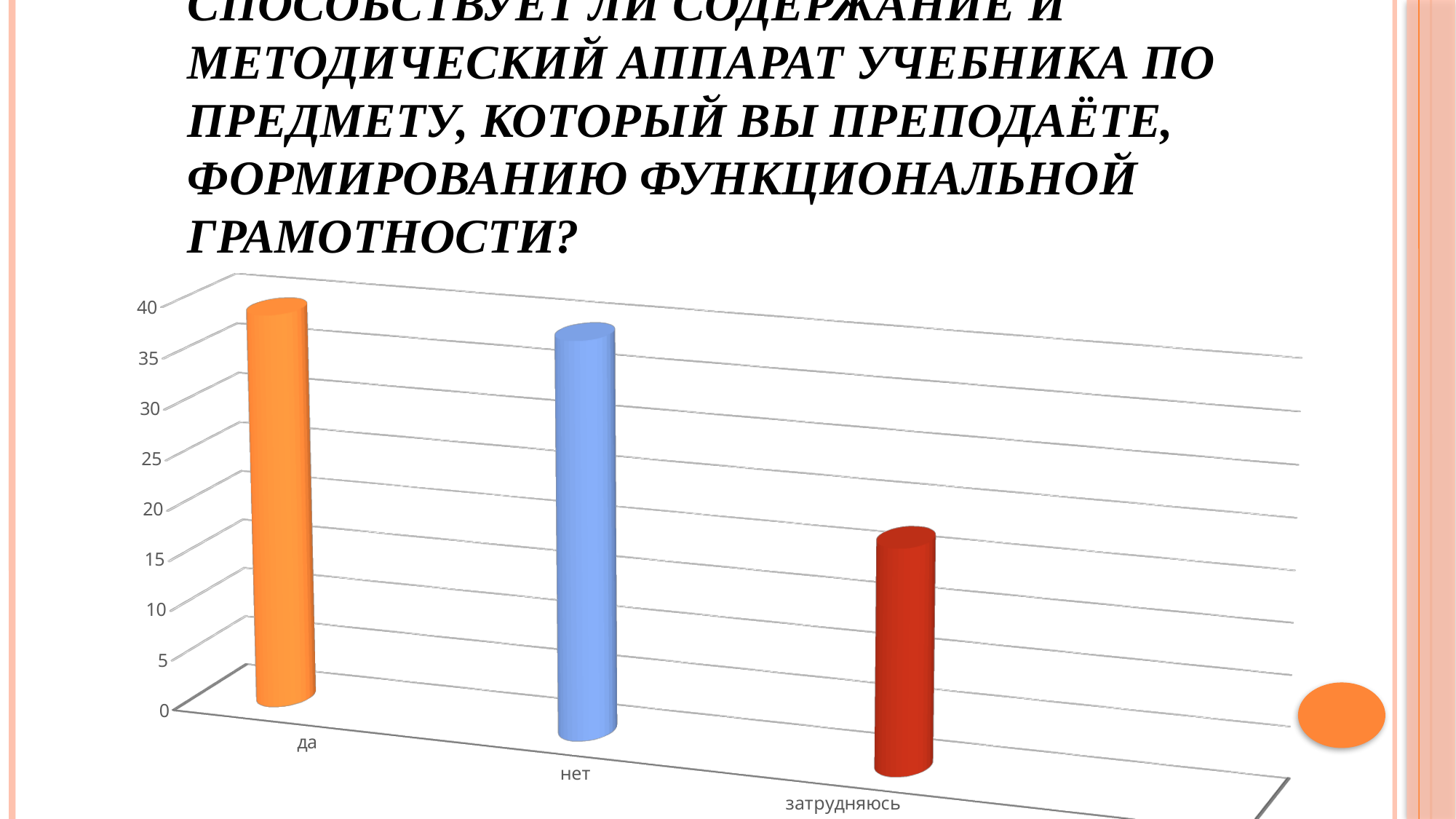
Which is larger, the value for "да" or the value for "затрудняюсь"? да What colour is the bar for "нет"? blue Is the value for "затрудняюсь" greater or less than 10? greater Which is larger, the value for "нет" or the value for "затрудняюсь"? нет Is the value for "да" greater or less than 30? greater How many categories are shown on the x axis of the chart? 3 Is the value for "затрудняюсь" greater or less than 25? less Which category has the lowest value in the chart? затрудняюсь What is the highest value shown on the vertical axis of the chart? 40 What kind of chart is shown on the slide? bar chart